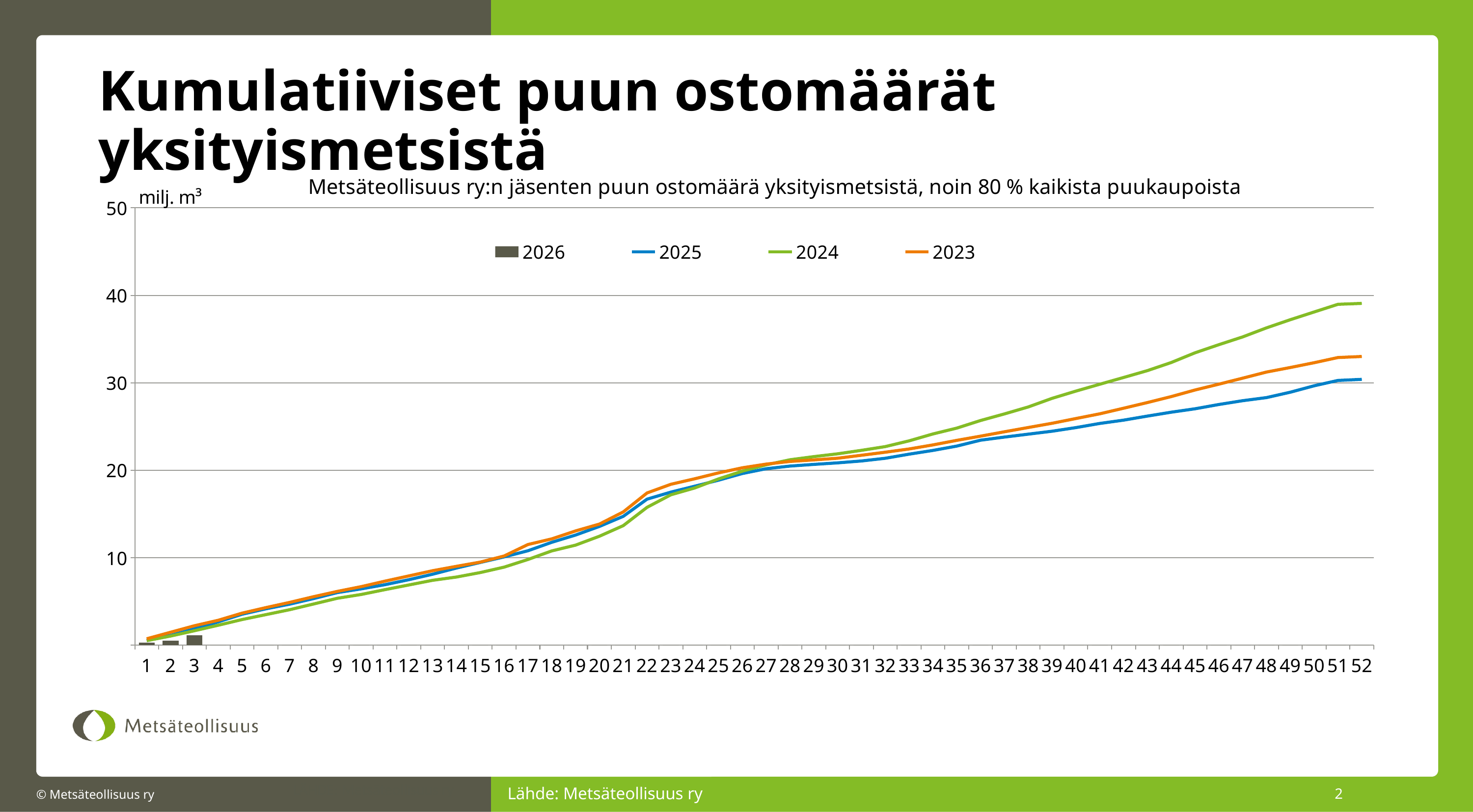
Which series has the highest value at week 52? 2024 At week 52, which is larger: the value for 2024 or the value for 2023? 2024 How many series does the legend list? 4 How many weeks are shown on the x axis? 52 Do the values for 2024 rise or fall along the x axis? rise Is the value for 2023 at week 52 greater or less than 30? greater Is the value for 2024 at week 16 greater or less than 10? less Is the value for 2024 at week 52 greater or less than 40? less Which series has the lowest value at week 52? 2025 Which years are listed in the chart legend? 2026, 2025, 2024, 2023 What unit is shown on the y axis? milj. m³